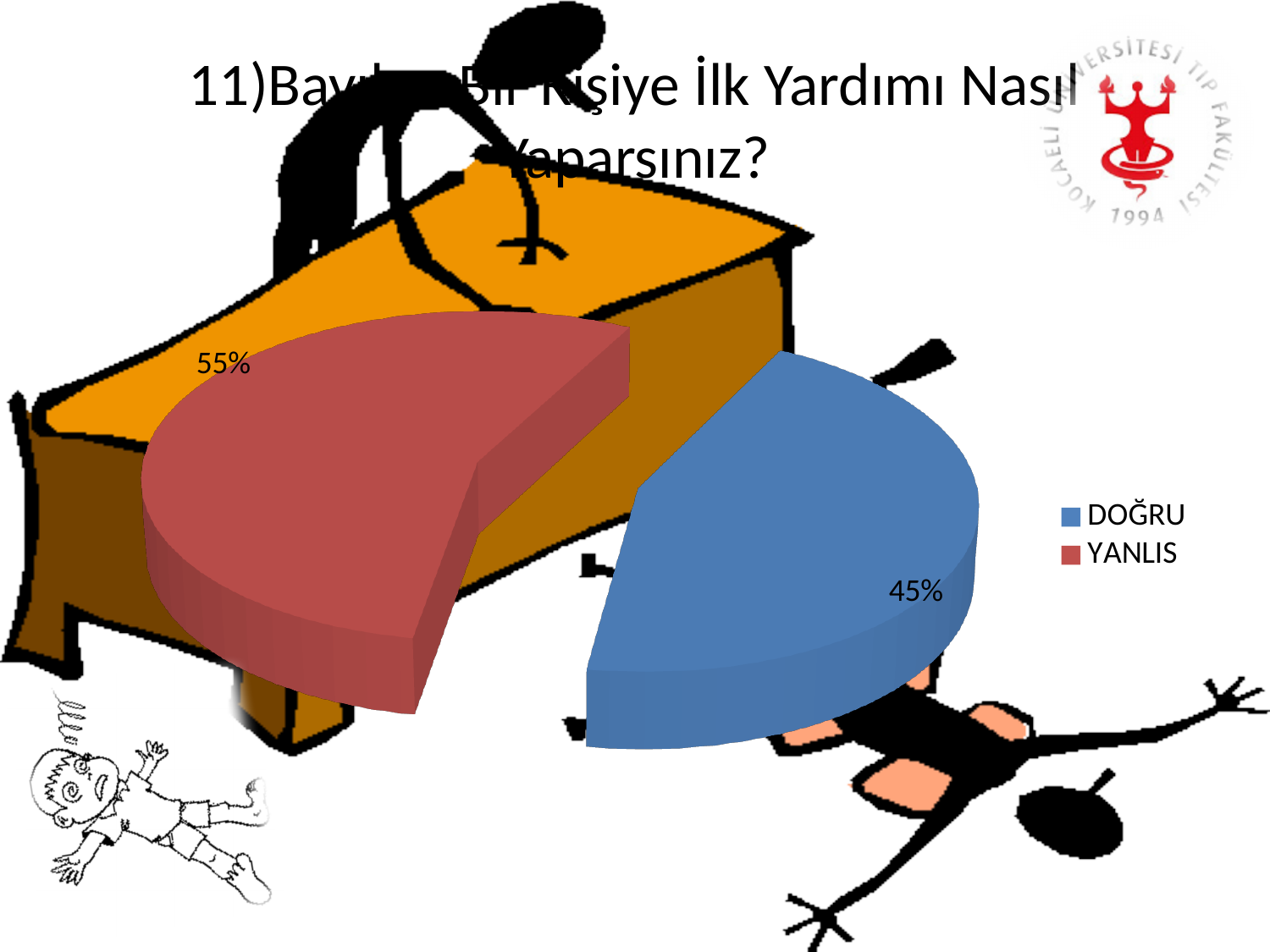
How many entries does the legend of the pie chart list? 2 Which slice of the pie chart is the largest? YANLIS Which is larger in the pie chart, DOĞRU or YANLIS? YANLIS What share of the pie does the blue slice represent? 45% What percentage of the pie chart is labelled YANLIS? 55% What kind of chart is shown on the slide? pie chart Which slice of the pie chart is the smallest? DOĞRU Which legend entry is shown in blue? DOĞRU What percentage of the pie chart is labelled DOĞRU? 45% What colour is the YANLIS slice in the pie chart? red What is the difference in percentage points between the YANLIS slice and the DOĞRU slice? 10 How many slices does the pie chart have? 2